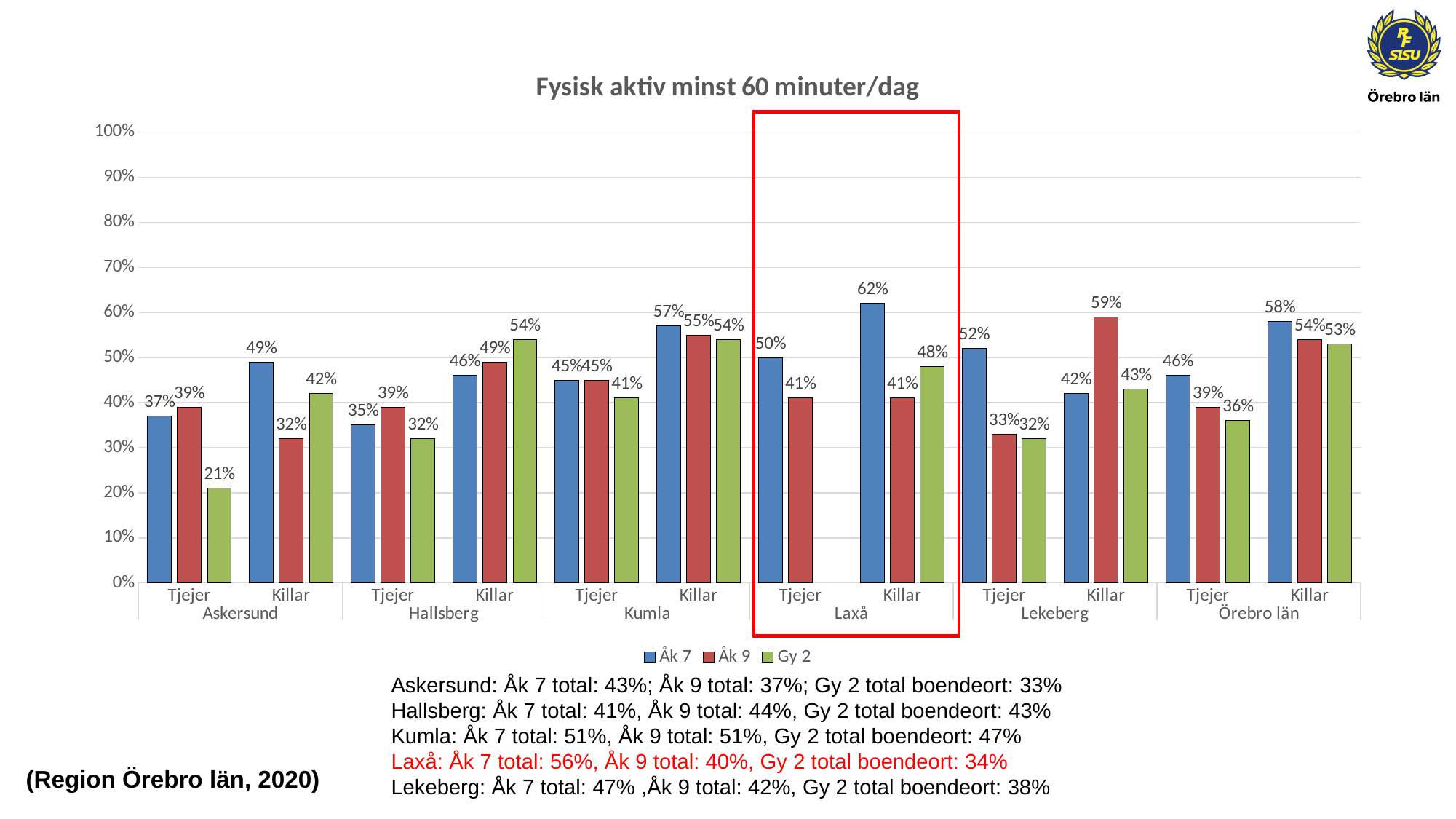
How many series does the legend list? 3 Which bar in the chart has the lowest value? Gy 2, Tjejer, Askersund (21%) How many municipalities/regions are shown along the x axis? 6 What is the difference between the Åk 7 values for Killar and Tjejer in Laxå? 12 percentage points What is the Åk 9 value for Killar in Lekeberg? 59% What kind of chart is shown on the slide? Bar chart What is the title of the chart? Fysisk aktiv minst 60 minuter/dag Which bar in the chart has the highest value? Åk 7, Killar, Laxå (62%) What is the Åk 7 value for Killar in Örebro län? 58% What is the Åk 7 value for Killar in Laxå? 62% Which is larger for Killar in Hallsberg: the Åk 7 value or the Gy 2 value? Gy 2 (54%) What is the Gy 2 value for Tjejer in Askersund? 21%